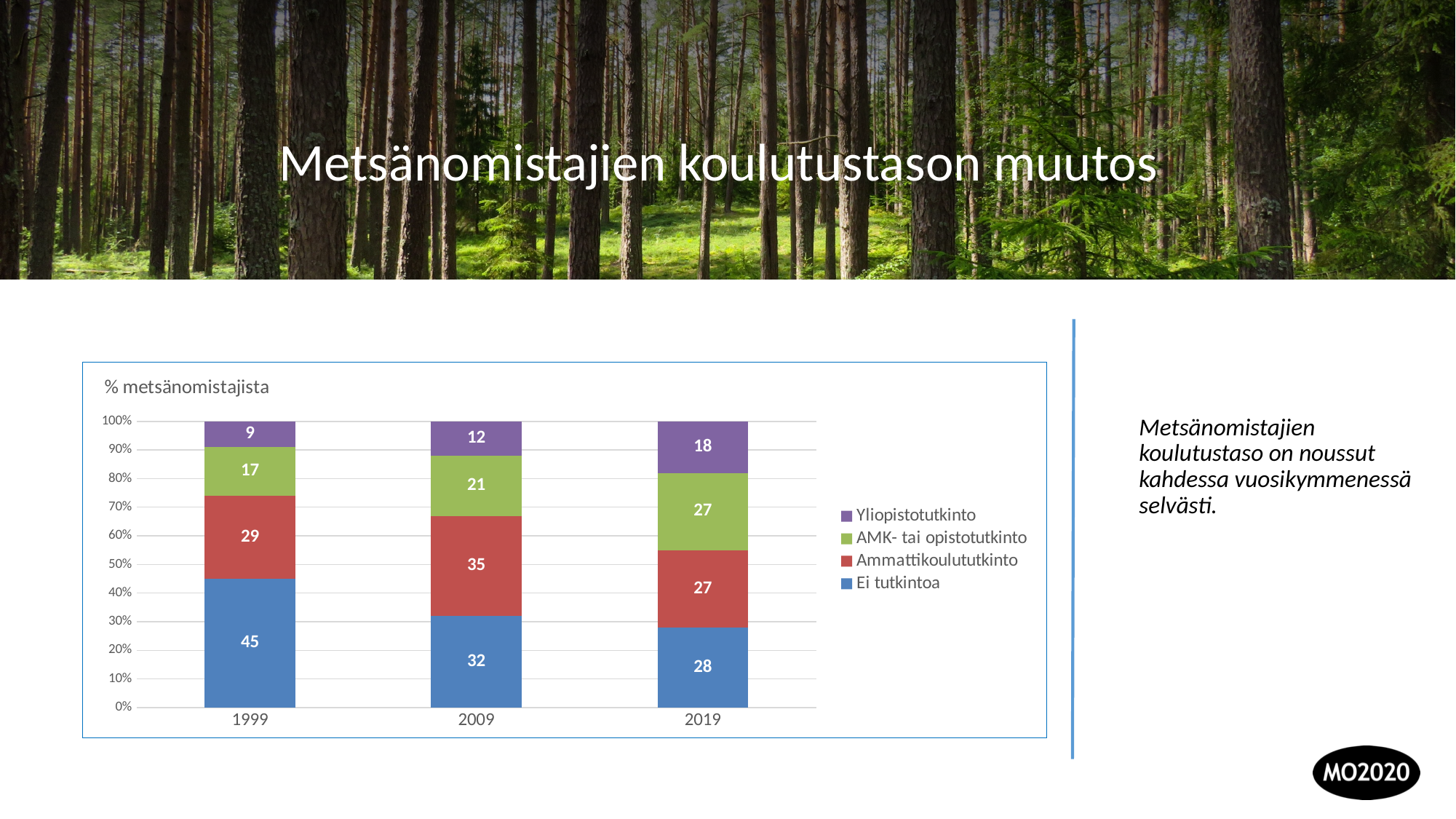
What is the value for AMK- tai opistotutkinto in 2009? 21 In which year is the value for Yliopistotutkinto the highest? 2019 How many years are shown on the x axis? 3 Which is larger, the Ammattikoulututkinto value in 2009 or in 2019? 2009 What is the difference between the Ei tutkintoa values for 1999 and 2019? 17 In which year is the value for Ei tutkintoa the lowest? 2019 Does the value for Yliopistotutkinto rise or fall from 1999 to 2019? Rise What is the value for Yliopistotutkinto in 2019? 18 How many series does the legend list? 4 What is the value for Ei tutkintoa in 1999? 45 What kind of chart is shown on the slide? Stacked bar chart What is the value for Ammattikoulututkinto in 2009? 35